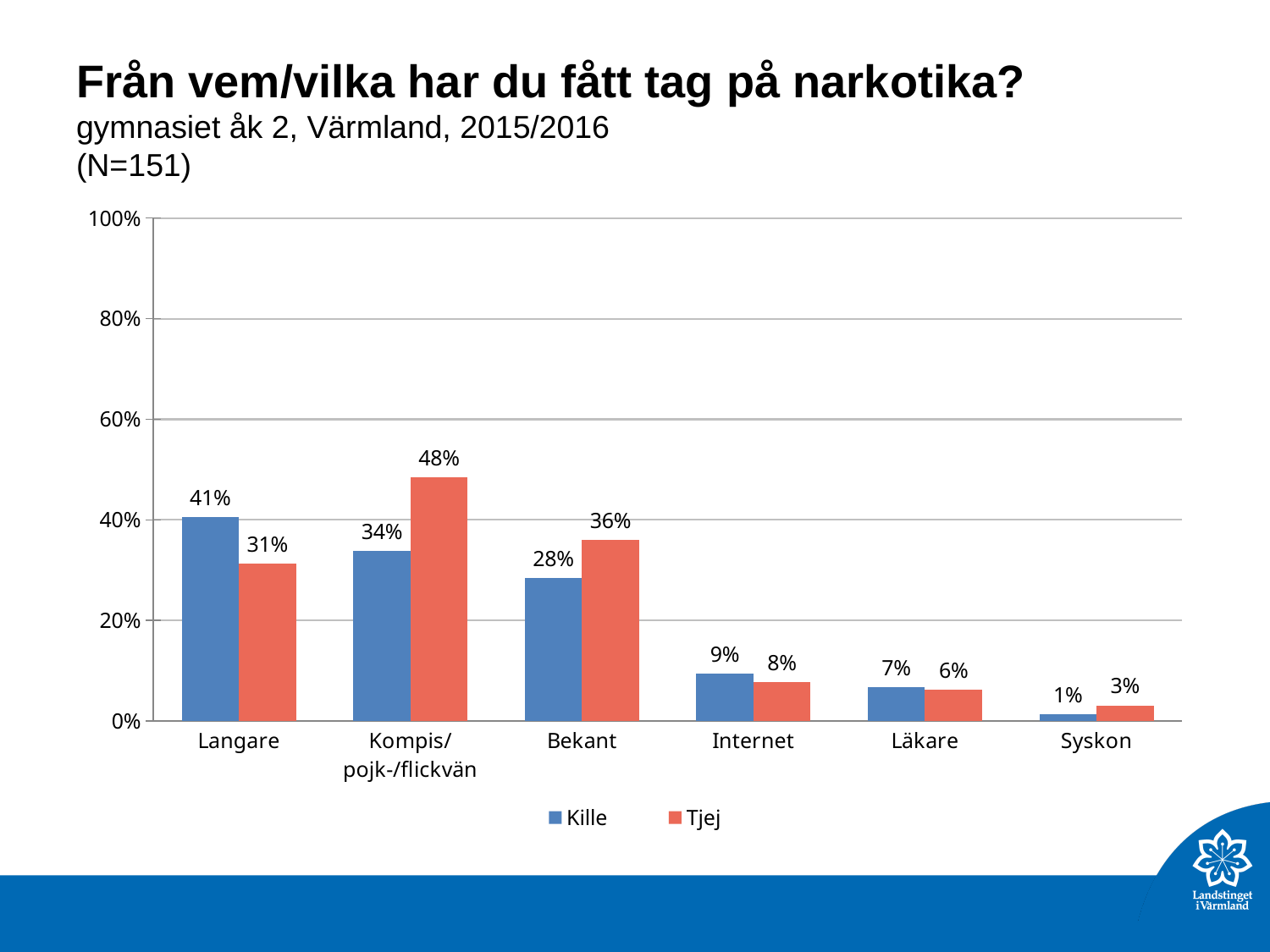
What kind of chart is shown on the slide? bar chart What is the difference between the Tjej and Kille values in the Bekant category? 8% How many series does the legend list? 2 Which category has the highest value for Tjej? Kompis/pojk-/flickvän Which is larger in the Langare category, the Kille value or the Tjej value? Kille What is the value for Kille in the Syskon category? 1% Is the value for Tjej in the Kompis/pojk-/flickvän category greater or less than 40%? greater What is the value for Tjej in the Kompis/pojk-/flickvän category? 48% What is the value for Kille in the Langare category? 41% How many categories are shown on the x axis? 6 What are the two series named in the legend? Kille and Tjej Which category has the lowest value for Kille? Syskon